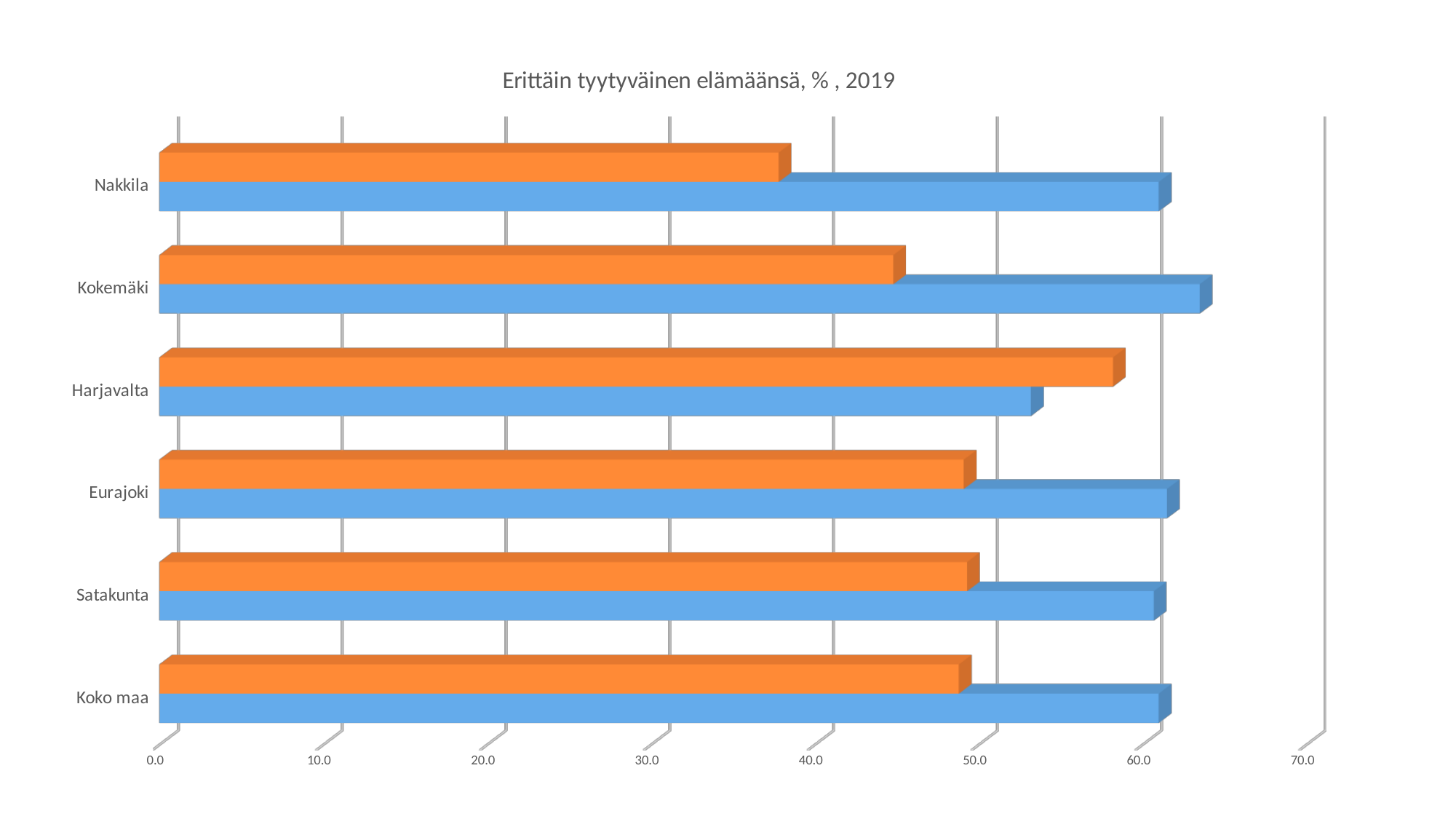
How many categories are shown on the vertical axis of the chart? 6 What kind of chart is shown on the slide? bar chart Is the orange bar for Harjavalta greater or less than 50? greater Is the blue bar for Kokemäki greater or less than 60? greater What is the title of the chart? Erittäin tyytyväinen elämäänsä, % , 2019 Which category has the shortest orange bar? Nakkila For Harjavalta, which bar is longer, the orange one or the blue one? orange For Nakkila, which bar is longer, the orange one or the blue one? blue Which category has the longest orange bar? Harjavalta Which category has the shortest blue bar? Harjavalta Is the orange bar for Nakkila greater or less than 40? less Which category has the longest blue bar? Kokemäki